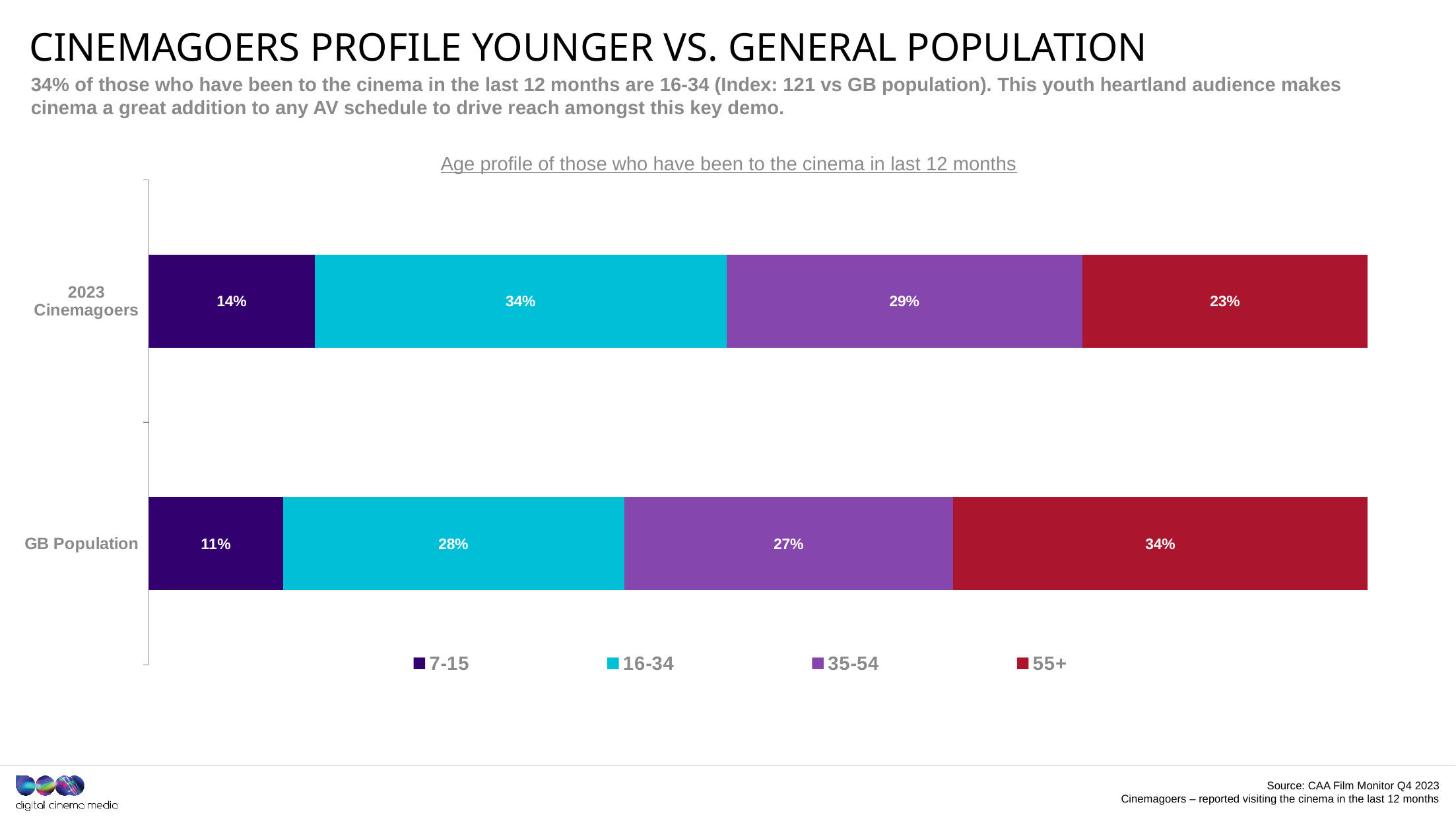
What is the value for the 7-15 age group among 2023 Cinemagoers? 14% What kind of chart is shown on the slide? Stacked bar chart Which age group has the largest share among 2023 Cinemagoers? 16-34 Which age group has the smallest share in the GB Population? 7-15 How many series does the legend list? 4 What percentage of the GB Population is aged 55+? 34% What is the value for the 35-54 age group in the GB Population bar? 27% Which is larger: the 55+ share for 2023 Cinemagoers or for the GB Population? GB Population What is the title of the chart? Age profile of those who have been to the cinema in last 12 months How many categories (bars) are shown on the chart? 2 What is the difference between the 16-34 share for 2023 Cinemagoers and for the GB Population? 6 percentage points What percentage of 2023 Cinemagoers are aged 16-34? 34%